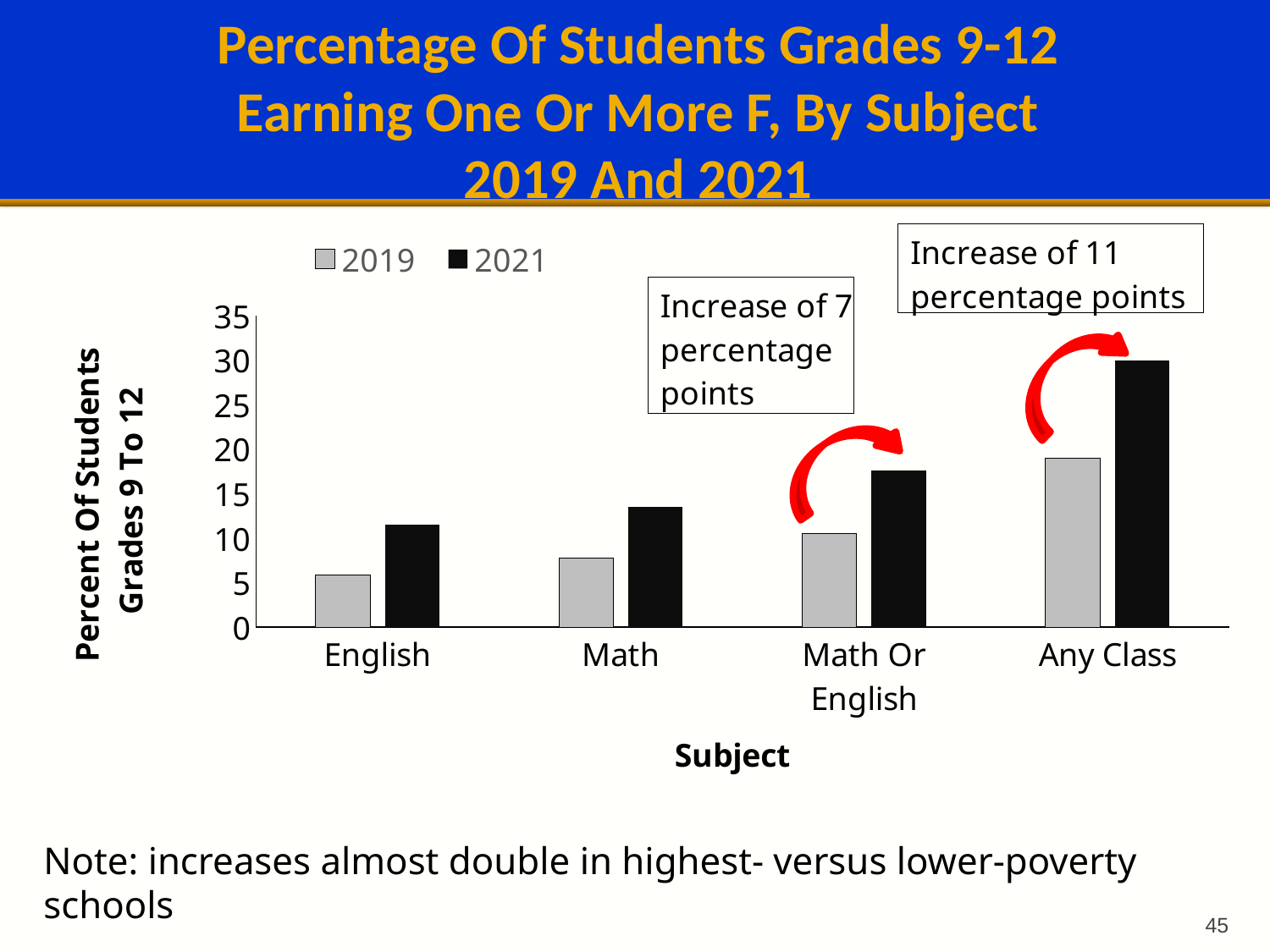
Which subject category has the highest 2021 value? Any Class How many subject categories are shown on the x axis? 4 According to the annotation, by how many percentage points did the Math Or English value increase from 2019 to 2021? 7 percentage points According to the annotation, by how many percentage points did the Any Class value increase from 2019 to 2021? 11 percentage points What kind of chart is shown on the slide? bar chart Is the 2019 value for English greater or less than 10? less How many series does the legend list? 2 Do the 2021 values rise or fall moving from English to Any Class along the x axis? rise Which subject category has the lowest 2019 value? English Which is larger for Math: the 2019 value or the 2021 value? 2021 Is the 2021 value for Any Class greater or less than 25? greater Is the 2021 value for Math Or English greater or less than 15? greater